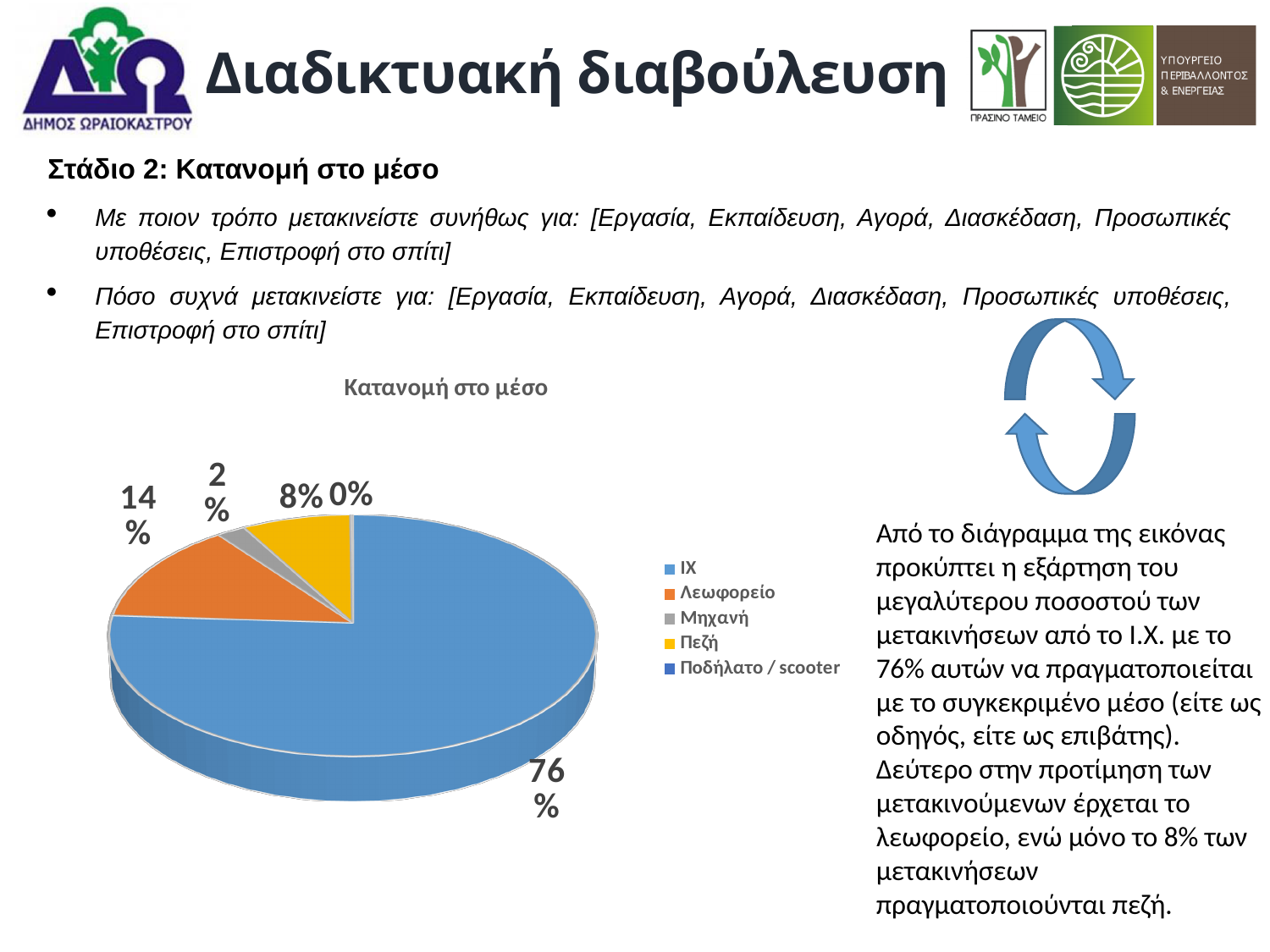
Which category has the largest slice of the pie? ΙΧ What share of the pie does Πεζή have? 8% What kind of chart is shown on the slide? pie chart Which category has the smallest slice of the pie? Ποδήλατο / scooter What share of the pie does Λεωφορείο have? 14% Which is larger, the share for Λεωφορείο or the share for Πεζή? Λεωφορείο What share of the pie does Ποδήλατο / scooter have? 0% What is the title of the chart? Κατανομή στο μέσο What is the difference between the shares of ΙΧ and Λεωφορείο? 62% How many categories does the legend of the pie chart list? 5